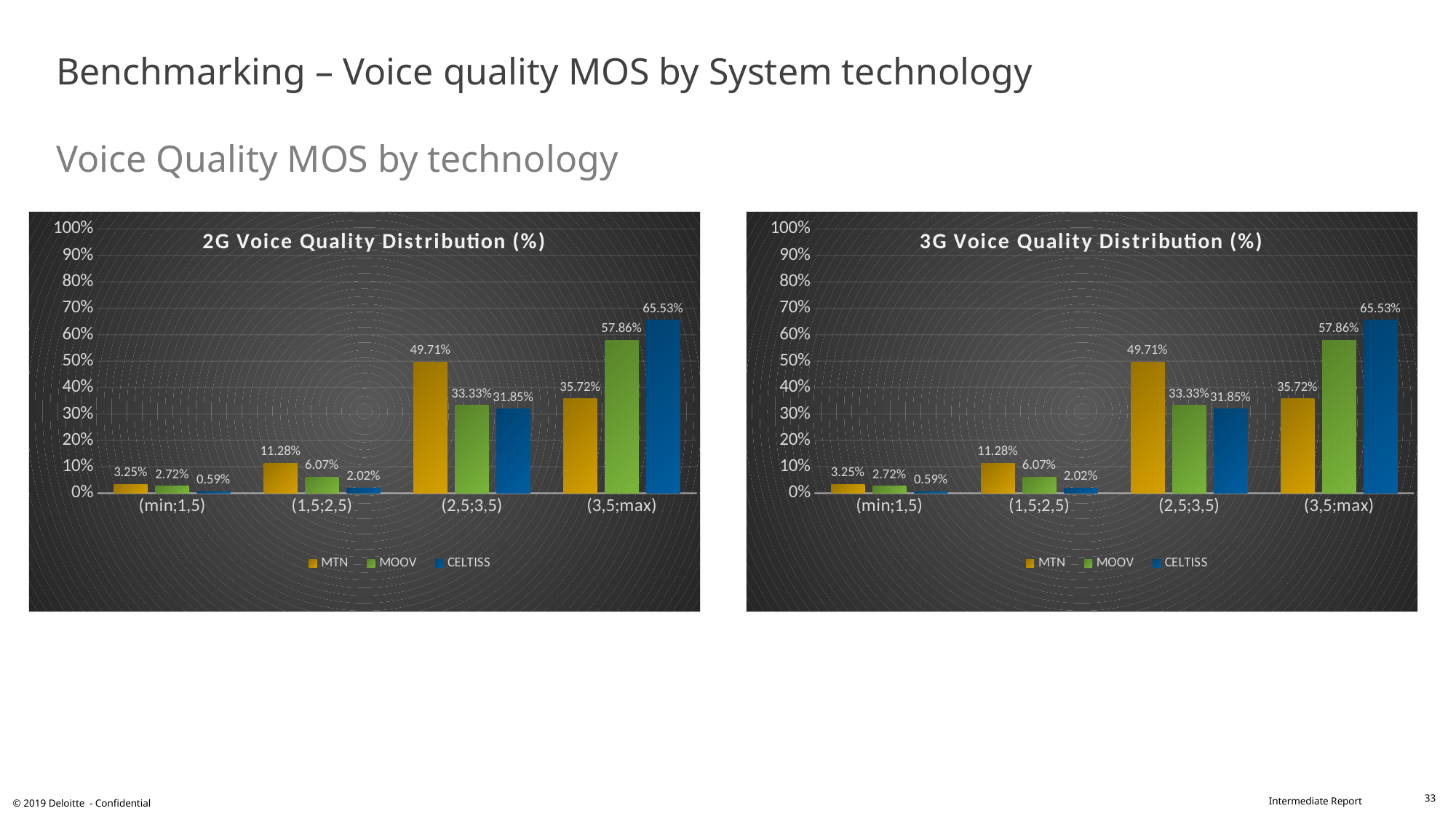
How many series does the legend of the 3G Voice Quality Distribution chart list? 3 In the 3G Voice Quality Distribution chart, which series has the lowest value in the (1,5;2,5) category? CELTISS What kind of chart is the 2G Voice Quality Distribution chart? Bar chart In the 3G Voice Quality Distribution chart, what is the total of the three series' values in the (min;1,5) category? 6.56% In the 2G Voice Quality Distribution chart, what is the value for MOOV in the (1,5;2,5) category? 6.07% In the 3G Voice Quality Distribution chart, what is the value for CELTISS in the (3,5;max) category? 65.53% In the 2G Voice Quality Distribution chart, what is the value for MTN in the (2,5;3,5) category? 49.71% In the 3G Voice Quality Distribution chart, what is the value for CELTISS in the (min;1,5) category? 0.59% In the 2G Voice Quality Distribution chart, what is the difference between the MOOV and CELTISS values in the (3,5;max) category? 7.67% In the 2G Voice Quality Distribution chart, which series has the highest value in the (3,5;max) category? CELTISS In the 3G Voice Quality Distribution chart, which is larger in the (2,5;3,5) category: MOOV or CELTISS? MOOV In the 2G Voice Quality Distribution chart, how many categories are shown on the x axis? 4